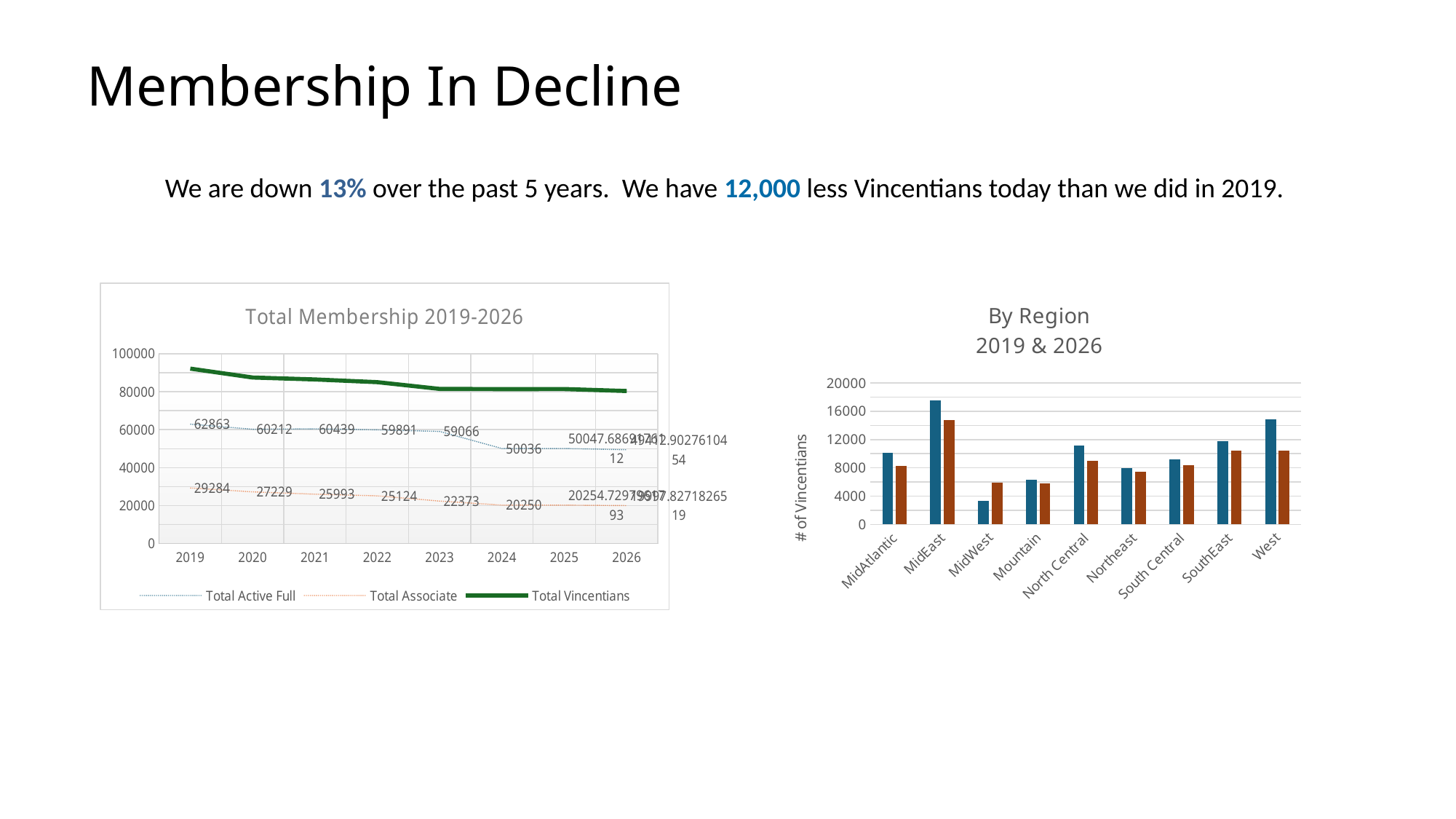
In the "Total Membership 2019-2026" chart, what is the difference between the Total Active Full values for 2019 and 2024? 12827 In the "Total Membership 2019-2026" chart, what is the Total Associate value for 2023? 22373 In the "Total Membership 2019-2026" chart, what is the Total Active Full value for 2019? 62863 How many regions are shown on the x axis of the "By Region 2019 & 2026" chart? 9 How many series does the legend of the "Total Membership 2019-2026" chart list? 3 In the "Total Membership 2019-2026" chart, which year has the highest Total Associate value? 2019 What kind of chart is the "By Region 2019 & 2026" chart? bar chart In the "Total Membership 2019-2026" chart, what is the difference between the Total Associate values for 2019 and 2020? 2055 In the "By Region 2019 & 2026" chart, is the value of the first (blue) bar for MidEast greater or less than 16000? greater What kind of chart is the "Total Membership 2019-2026" chart? line chart In the "By Region 2019 & 2026" chart, which region has the tallest bar? MidEast In the "Total Membership 2019-2026" chart, does the Total Vincentians line rise or fall from 2019 to 2026? fall